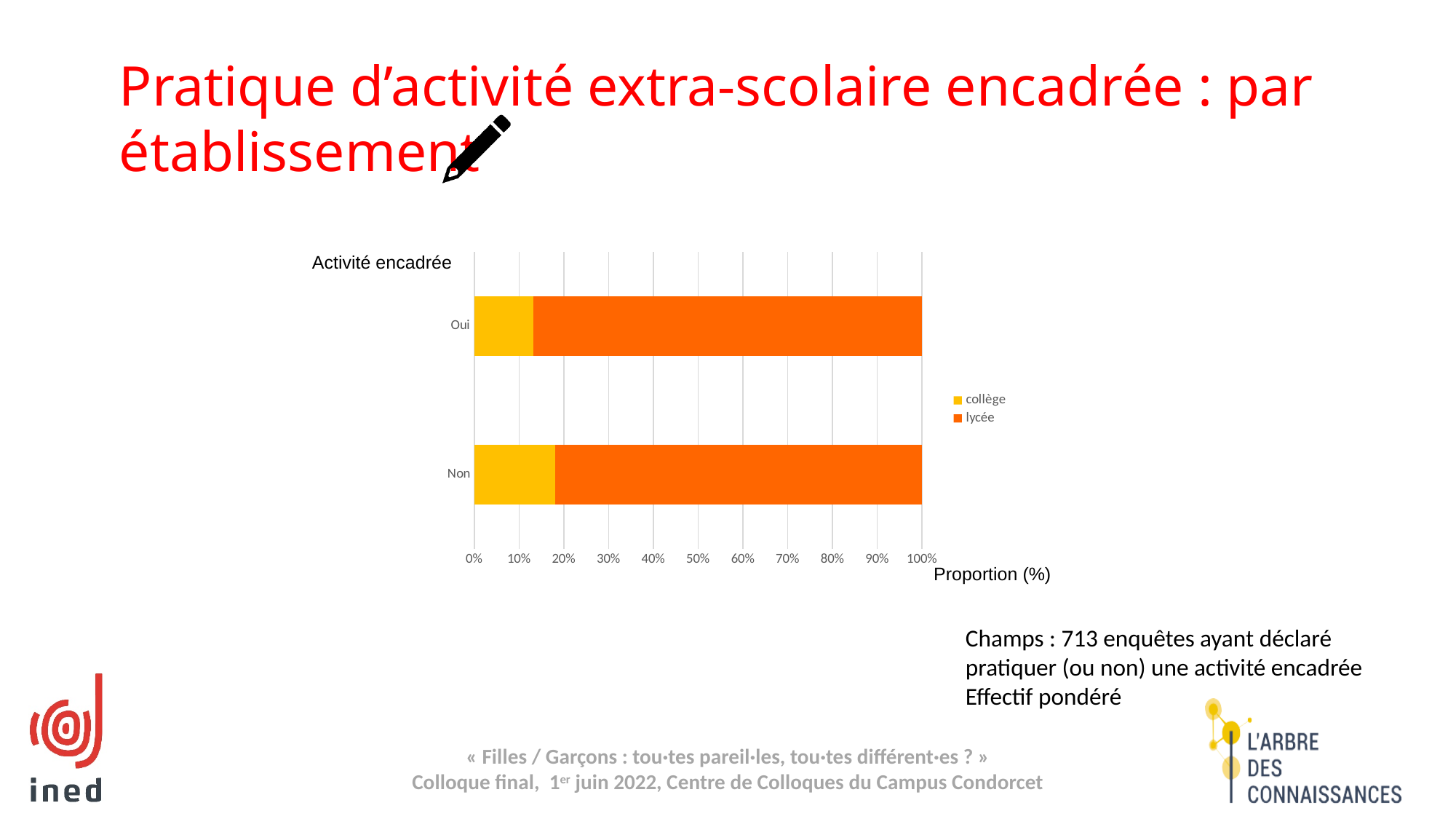
What is the title of the horizontal axis? Proportion (%) Is the lycée share of the Oui bar greater or less than 80%? greater Which category has the larger collège share, Oui or Non? Non Is the lycée share of the Non bar greater or less than 50%? greater How many series does the legend list? 2 Is the collège share of the Oui bar greater or less than 20%? less Which category has the larger lycée share, Oui or Non? Oui How many categories are shown on the vertical axis of the chart? 2 What kind of chart is shown on the slide? Stacked bar chart Which series are listed in the legend? collège and lycée What is the total of the stacked Oui bar? 100%